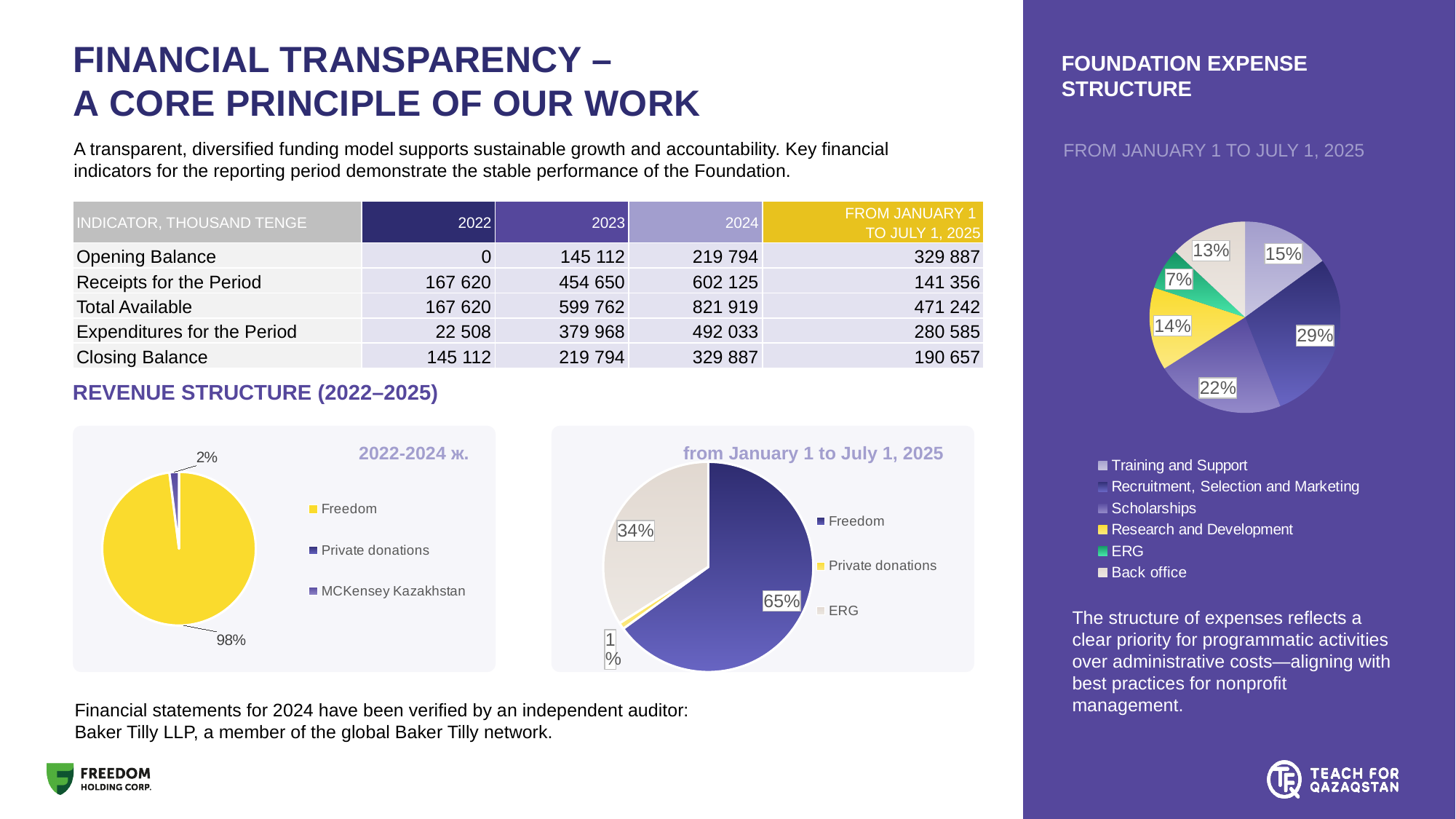
In the 'Foundation Expense Structure' pie chart, which is larger: Scholarships or Research and Development? Scholarships What kind of chart is used for the 'Foundation Expense Structure'? Pie chart In the 'from January 1 to July 1, 2025' pie chart, what share does Freedom have? 65% How many categories does the legend of the 'Foundation Expense Structure' pie chart list? 6 In the 'from January 1 to July 1, 2025' pie chart, which source has the largest share? Freedom In the 'from January 1 to July 1, 2025' pie chart, what is the difference between the Freedom share and the ERG share? 31% In the 'Foundation Expense Structure' pie chart, what share goes to Recruitment, Selection and Marketing? 29% How many entries does the legend of the '2022-2024 ж.' pie chart list? 3 In the 'from January 1 to July 1, 2025' pie chart, what share does ERG have? 34% In the '2022-2024 ж.' pie chart, what share does Freedom have? 98% In the 'Foundation Expense Structure' pie chart, which category has the smallest share? ERG